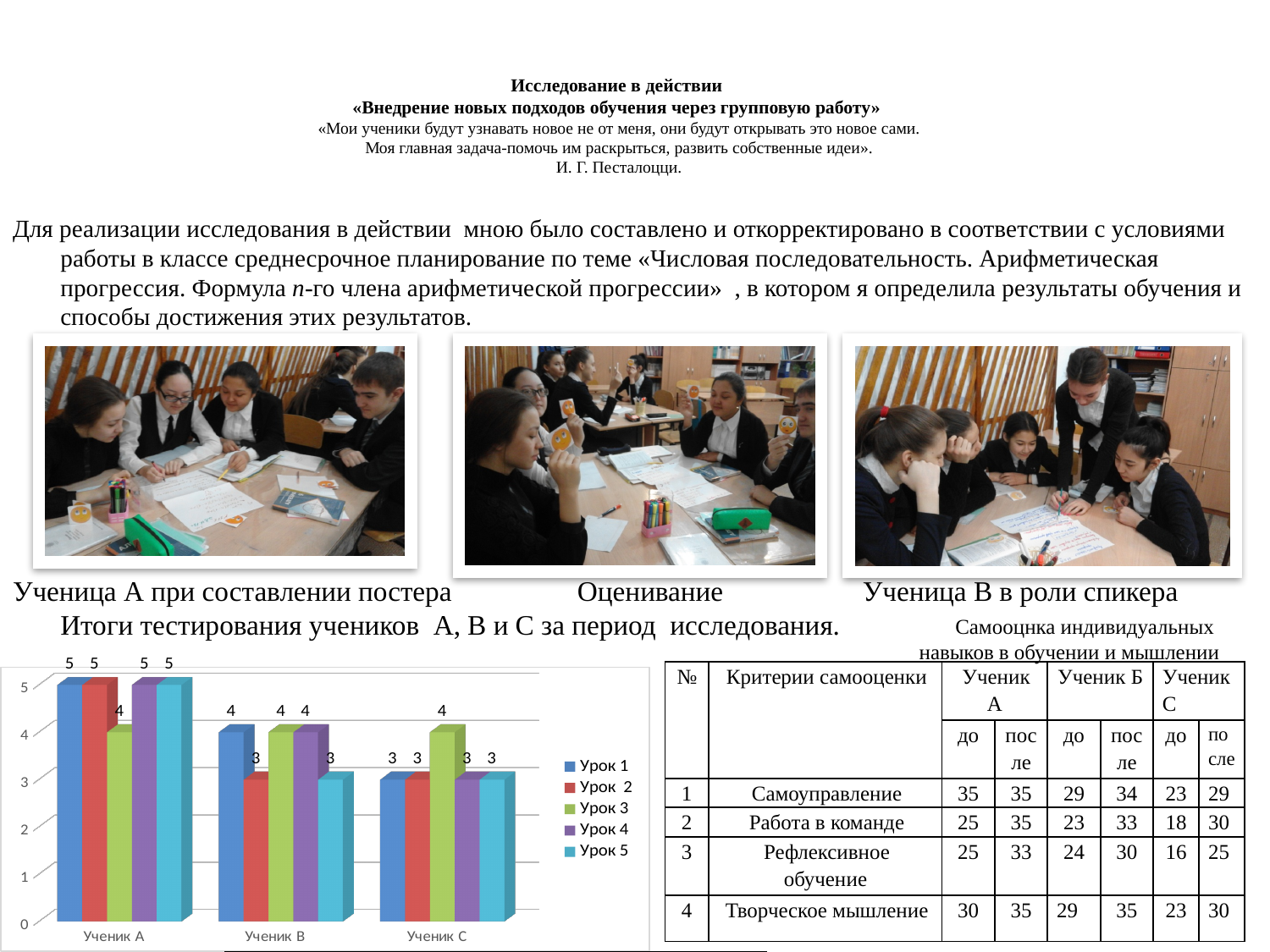
Which lesson has the highest value for Ученик C? Урок 3 What is the value for Ученик A in Урок 1? 5 How many student categories are shown on the x axis of the chart? 3 What is the difference between the Урок 1 values for Ученик A and Ученик C? 2 What is the value for Ученик B in Урок 2? 3 What is the value for Ученик C in Урок 3? 4 What kind of chart is shown on the slide? bar chart How many series does the chart legend list? 5 Which lesson has the lowest value for Ученик A? Урок 3 Which series is shown in green in the chart legend? Урок 3 Which is larger: the Урок 4 value for Ученик B or the Урок 4 value for Ученик C? Ученик B What is the value for Ученик A in Урок 3? 4